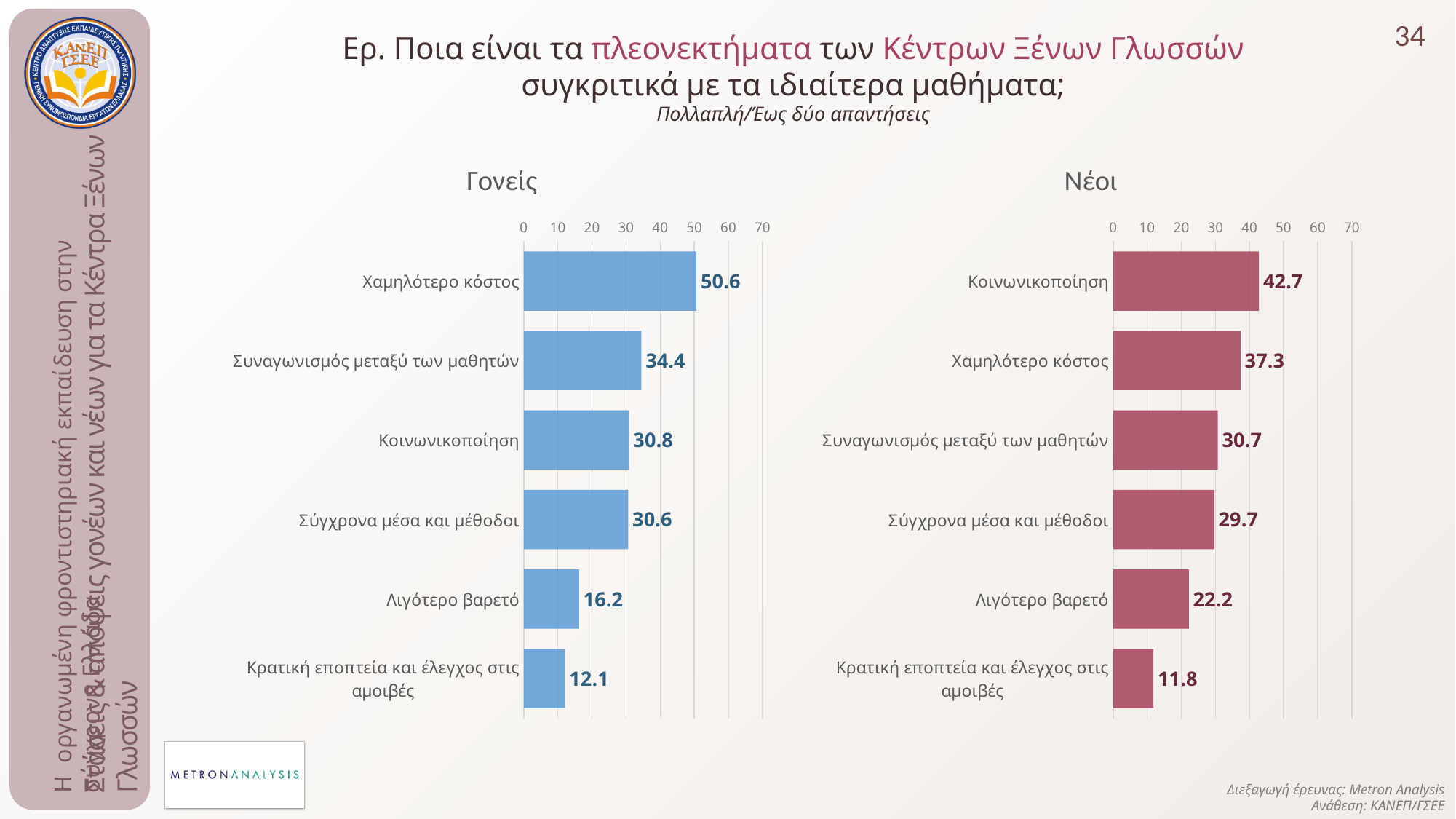
In the Γονείς chart, which category has the highest value? Χαμηλότερο κόστος In the Νέοι chart, what is the value for Λιγότερο βαρετό? 22.2 In the Νέοι chart, what is the difference between Κοινωνικοποίηση and Χαμηλότερο κόστος? 5.4 What type of chart is the Νέοι chart? bar chart Which is larger: Χαμηλότερο κόστος in the Γονείς chart or Χαμηλότερο κόστος in the Νέοι chart? Γονείς How many categories are shown in the Γονείς chart? 6 What colour are the bars in the Γονείς chart? blue In the Νέοι chart, which category has the lowest value? Κρατική εποπτεία και έλεγχος στις αμοιβές In the Νέοι chart, what is the value for Κοινωνικοποίηση? 42.7 In the Γονείς chart, what is the difference between Χαμηλότερο κόστος and Συναγωνισμός μεταξύ των μαθητών? 16.2 In the Νέοι chart, is the value for Συναγωνισμός μεταξύ των μαθητών greater or less than 40? less In the Γονείς chart, what is the value for Χαμηλότερο κόστος? 50.6